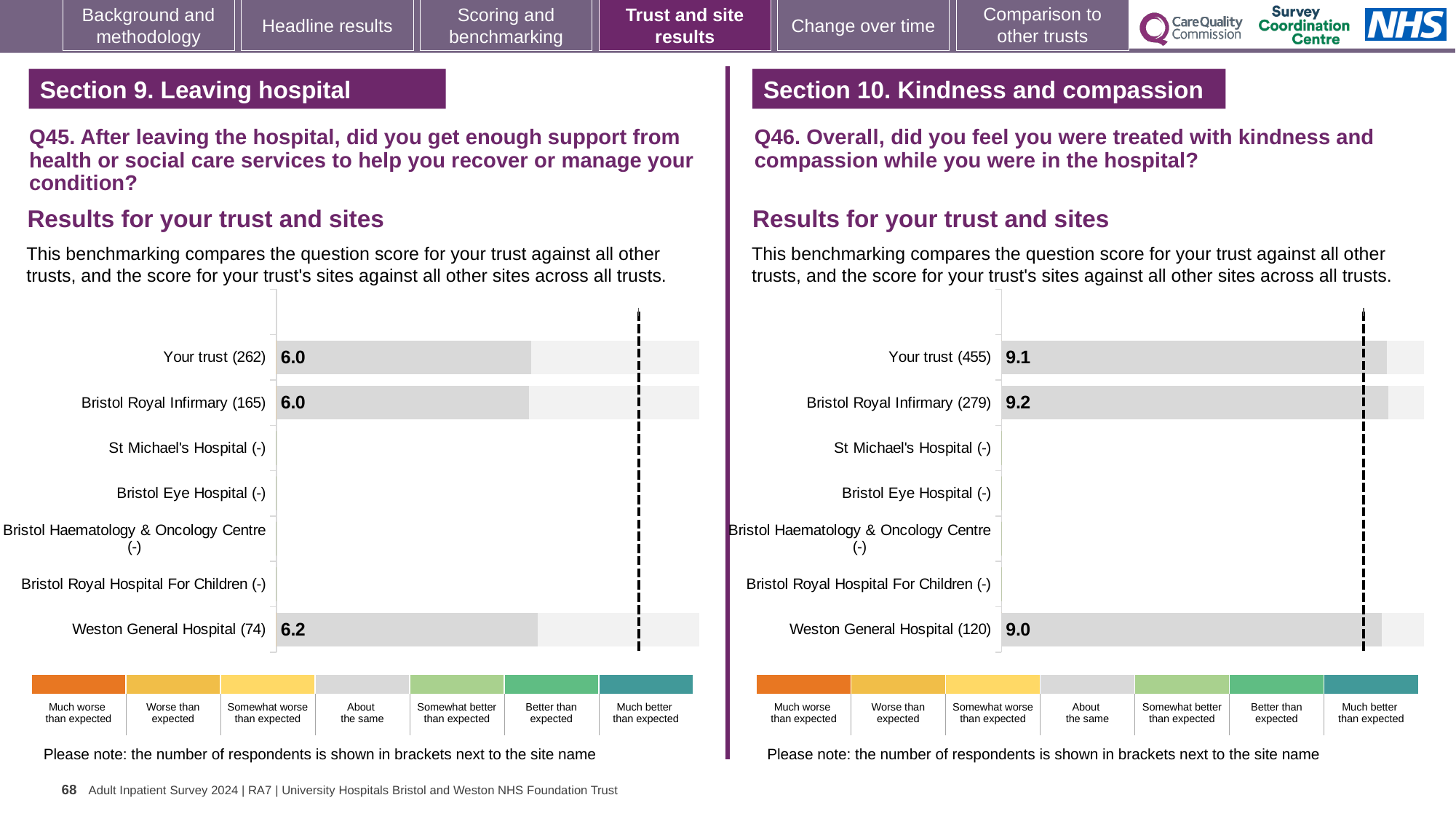
In the Q46 chart on the right, what is the score for Bristol Royal Infirmary? 9.2 In the Q45 chart on the left, what is the score for Weston General Hospital? 6.2 In the Q46 chart on the right, what is the difference between the Bristol Royal Infirmary score and the Weston General Hospital score? 0.2 In the Q45 chart on the left, what is the score for Your trust? 6.0 In the Q45 chart on the left, what is the score for Bristol Royal Infirmary? 6.0 In the Q45 chart on the left, how many respondents are shown in brackets for Your trust? 262 In the Q46 chart on the right, what is the score for Weston General Hospital? 9.0 What kind of chart is used in the Q45 chart on the left? Bar chart How many site or trust rows are listed in the Q46 chart on the right? 7 In the Q46 chart on the right, what is the score for Your trust? 9.1 In the Q46 chart on the right, which site has the lowest score? Weston General Hospital In the Q45 chart on the left, which site has the highest score? Weston General Hospital